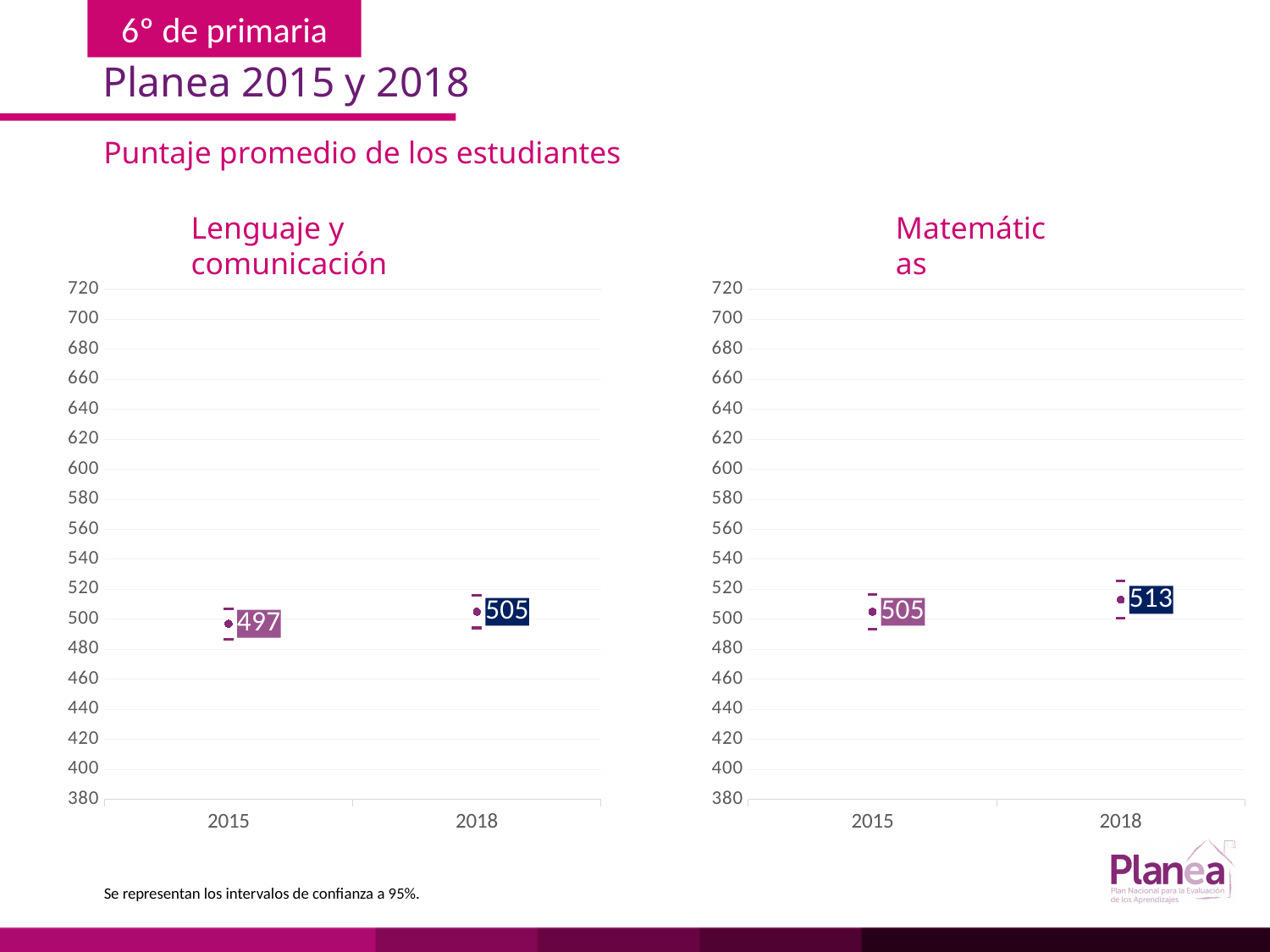
In the 'Matemáticas' chart, what is the average score for 2018? 513 In the 'Lenguaje y comunicación' chart, which year has the lowest score? 2015 In the 'Lenguaje y comunicación' chart, what is the average score for 2015? 497 In the 'Matemáticas' chart, is the 2018 score greater or less than 500? greater In the 'Lenguaje y comunicación' chart, do the scores rise or fall from 2015 to 2018? rise In the 'Matemáticas' chart, what is the average score for 2015? 505 In the 'Matemáticas' chart, what is the difference between the 2018 and 2015 scores? 8 In the 'Matemáticas' chart, which year has the higher score, 2015 or 2018? 2018 What is the lowest value shown on the y axis of the 'Lenguaje y comunicación' chart? 380 In the 'Lenguaje y comunicación' chart, what is the average score for 2018? 505 In the 'Lenguaje y comunicación' chart, by how many points did the score change from 2015 to 2018? 8 How many years are plotted on the x axis of the 'Matemáticas' chart? 2